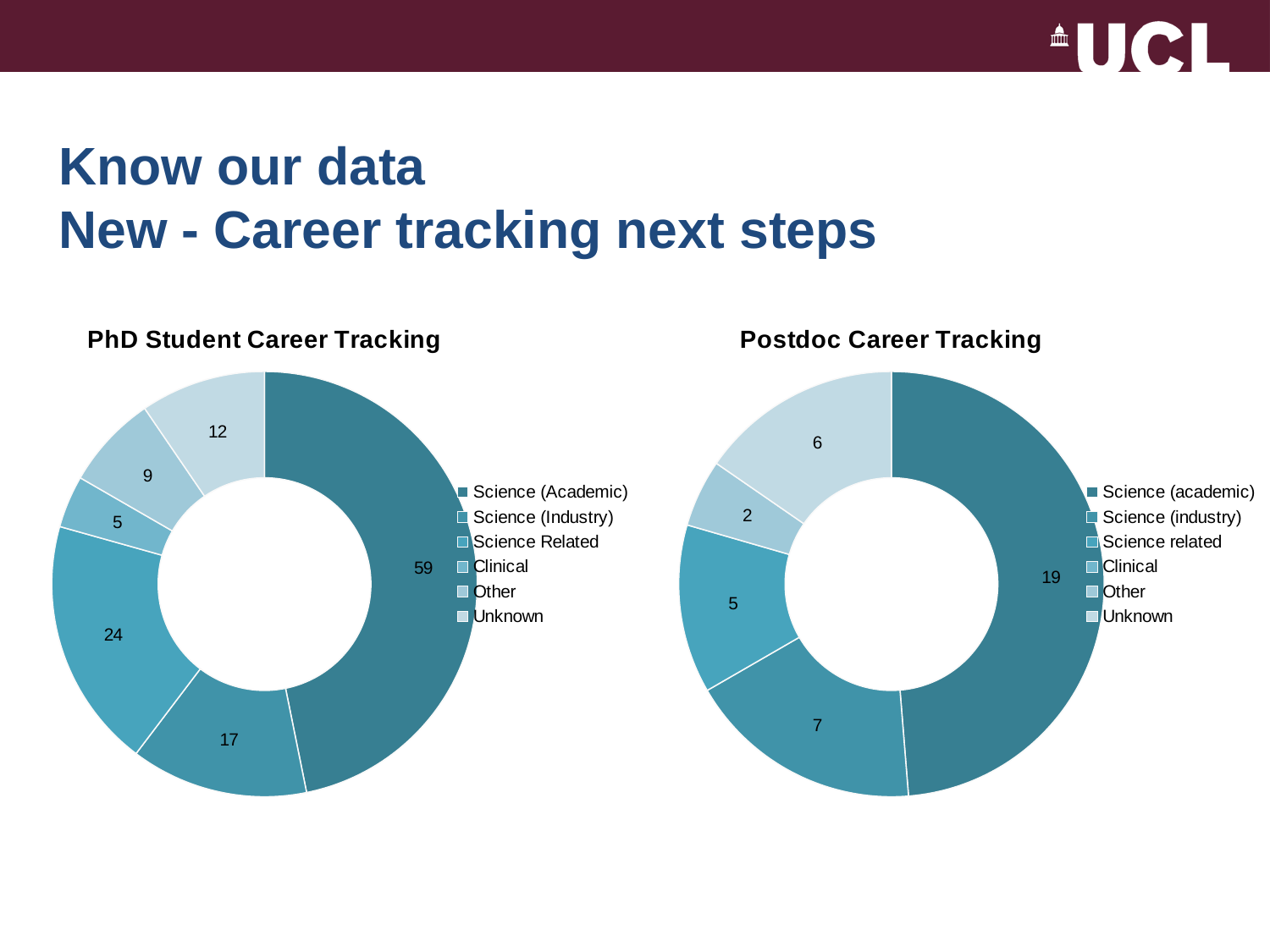
In the Postdoc Career Tracking chart, what is the difference between Science (academic) and Science (industry)? 12 How many entries does the legend of the PhD Student Career Tracking chart list? 6 In the PhD Student Career Tracking chart, what is the difference between Science (Academic) and Science Related? 35 In the PhD Student Career Tracking chart, which category has the smallest value? Clinical In the PhD Student Career Tracking chart, what is the value for Science Related? 24 In the Postdoc Career Tracking chart, which category has the largest value? Science (academic) In the PhD Student Career Tracking chart, what is the value for Science (Academic)? 59 In the Postdoc Career Tracking chart, what is the value for Science (industry)? 7 What type of chart is the Postdoc Career Tracking chart? Doughnut chart In the PhD Student Career Tracking chart, which category has the largest value? Science (Academic) In the Postdoc Career Tracking chart, what is the value for Science (academic)? 19 In the PhD Student Career Tracking chart, which is larger, Science (Industry) or Unknown? Science (Industry)